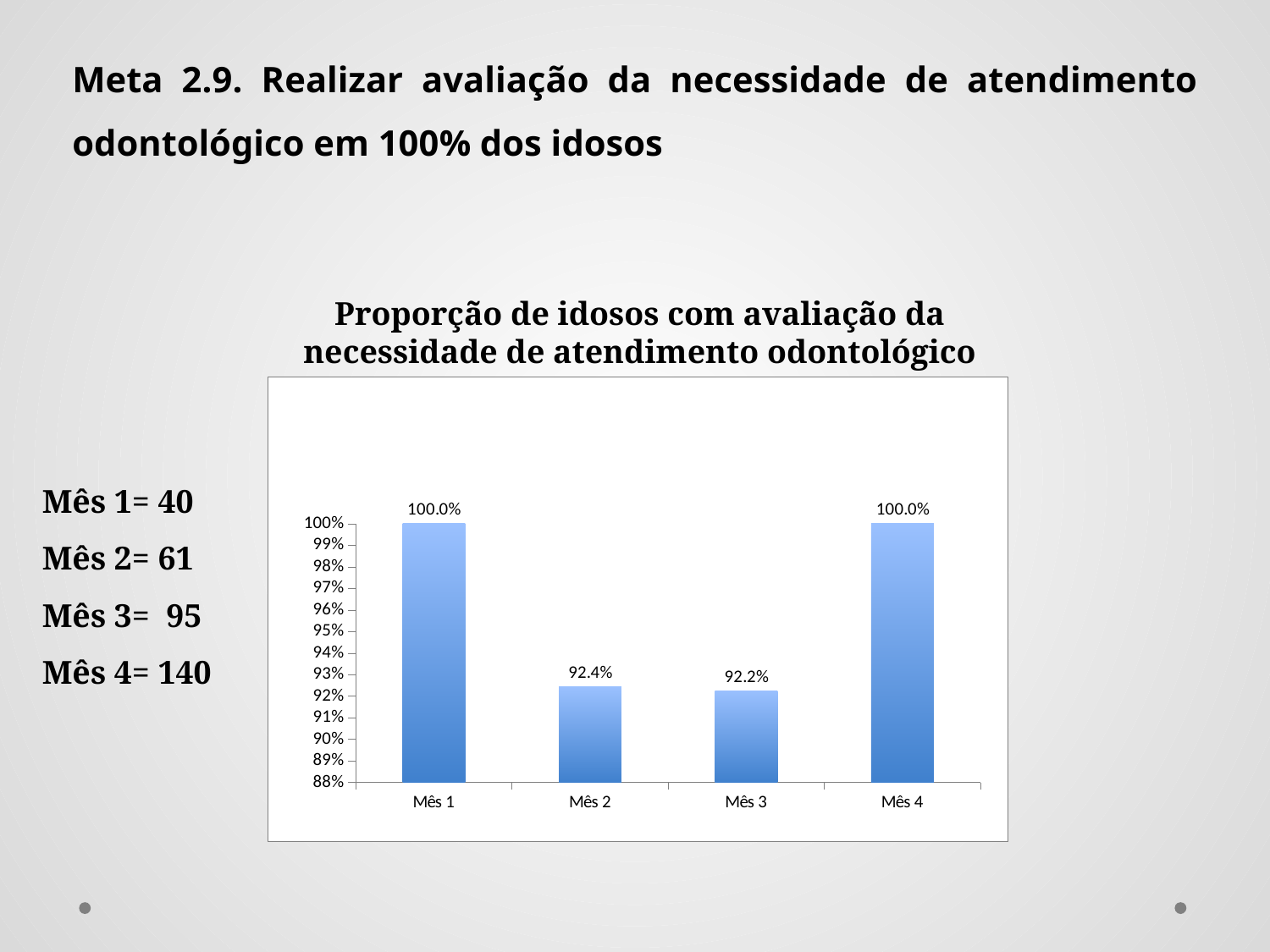
What is the difference between the values for Mês 4 and Mês 3? 7.8% What is the difference between the values for Mês 1 and Mês 2? 7.6% What kind of chart is shown on the slide? bar chart How many categories are shown on the x axis? 4 Which is larger, the value for Mês 1 or the value for Mês 2? Mês 1 What is the value for Mês 2? 92.4% What is the value for Mês 1? 100.0% Is the value for Mês 2 greater or less than 95%? less What is the value for Mês 3? 92.2% Is the value for Mês 3 greater or less than 90%? greater What is the title of the chart? Proporção de idosos com avaliação da necessidade de atendimento odontológico What is the value for Mês 4? 100.0%